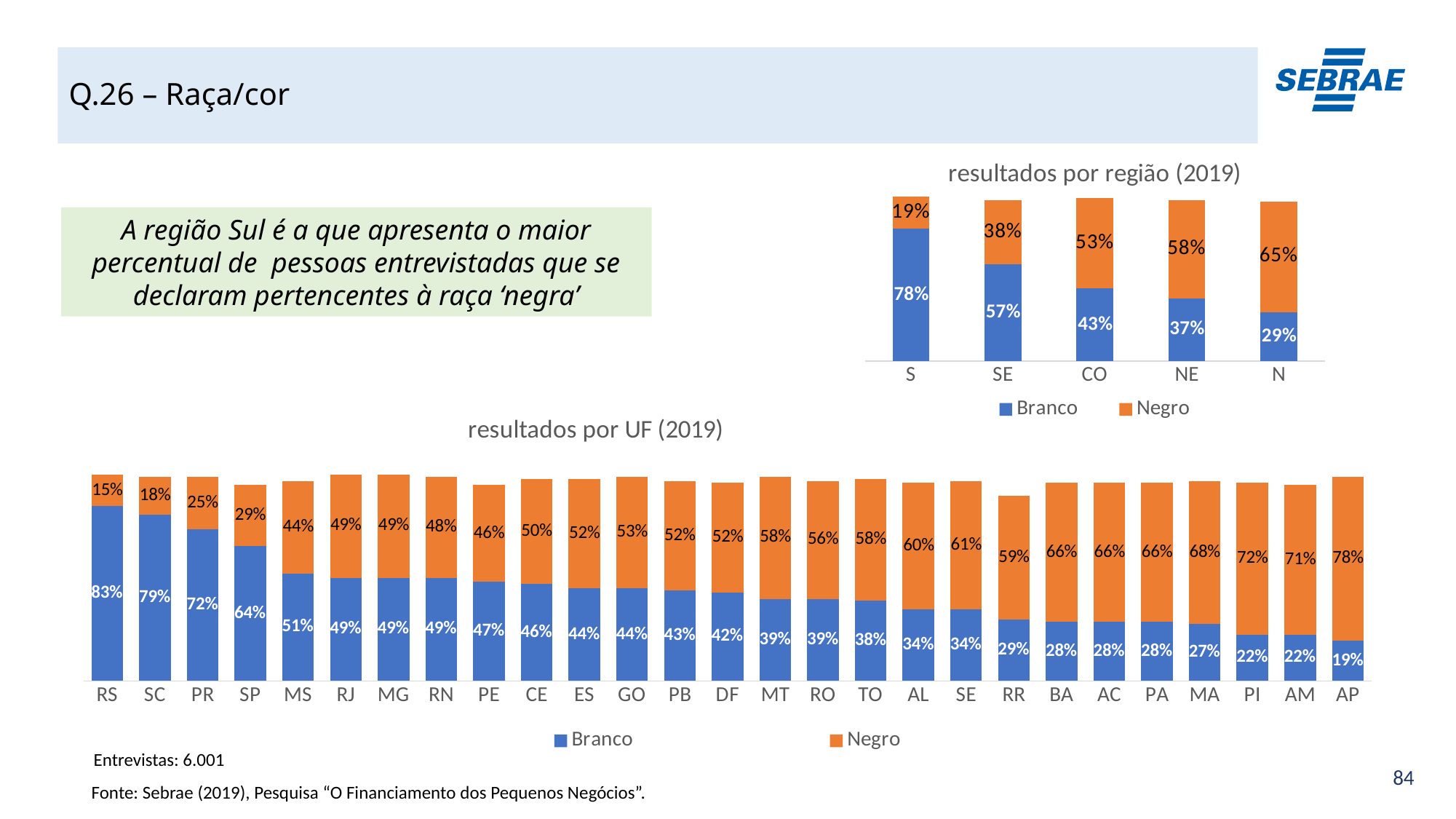
In the 'resultados por UF (2019)' chart, how many series does the legend list? 2 In the 'resultados por região (2019)' chart, how many regions are shown on the x axis? 5 In the 'resultados por região (2019)' chart, which region has the highest Negro value? N In the 'resultados por UF (2019)' chart, how many UFs are shown on the x axis? 27 What kind of chart is the 'resultados por UF (2019)' chart? Stacked bar chart In the 'resultados por UF (2019)' chart, which UF has the lowest Branco value? AP In the 'resultados por região (2019)' chart, what is the Branco value for S? 78% In the 'resultados por região (2019)' chart, what is the Negro value for N? 65% In the 'resultados por UF (2019)' chart, what is the Negro value for AP? 78% In the 'resultados por região (2019)' chart, what is the difference between the Branco values for S and SE? 21% In the 'resultados por UF (2019)' chart, what is the Branco value for RS? 83% In the 'resultados por UF (2019)' chart, which is larger, the Negro value for SP or the Negro value for MS? MS